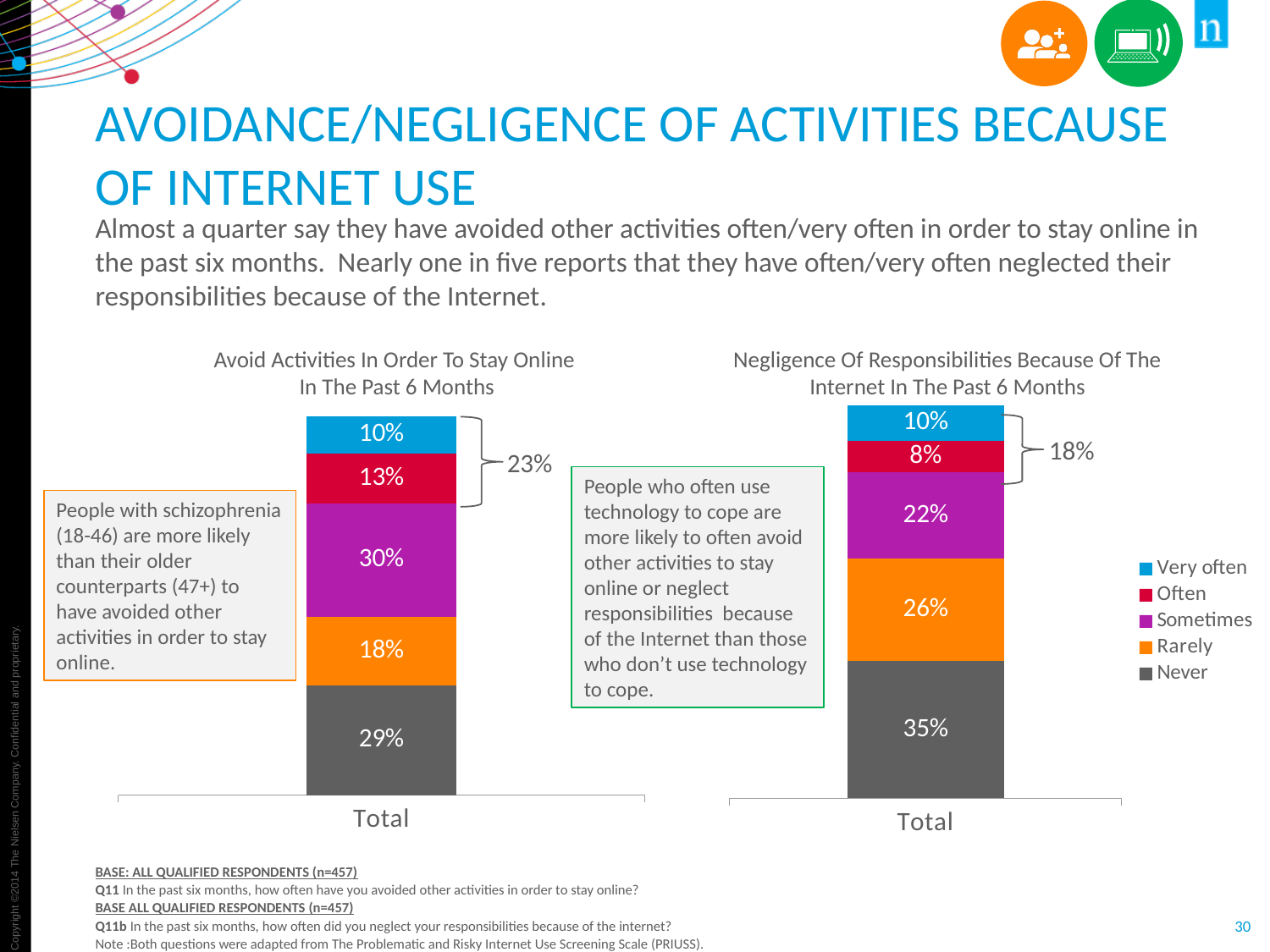
In the 'Avoid Activities In Order To Stay Online In The Past 6 Months' chart, what percentage is 'Sometimes'? 30% In the 'Negligence Of Responsibilities Because Of The Internet In The Past 6 Months' chart, what percentage is 'Often'? 8% In the 'Negligence Of Responsibilities Because Of The Internet In The Past 6 Months' chart, what is the combined percentage of 'Very often' and 'Often' shown by the bracket? 18% In the 'Avoid Activities In Order To Stay Online In The Past 6 Months' chart, which response category has the largest share? Sometimes In the 'Avoid Activities In Order To Stay Online In The Past 6 Months' chart, what percentage of the Total bar is 'Never'? 29% In the 'Avoid Activities In Order To Stay Online In The Past 6 Months' chart, what is the difference between the 'Sometimes' and 'Rarely' percentages? 12% How many response categories does the legend list? 5 What type of chart is used on this slide? Stacked bar chart In the 'Negligence Of Responsibilities Because Of The Internet In The Past 6 Months' chart, what percentage is 'Never'? 35% Is the 'Never' share larger in the 'Avoid Activities' chart or in the 'Negligence Of Responsibilities' chart? Negligence Of Responsibilities Which colour represents 'Rarely' in the legend? Orange In the 'Negligence Of Responsibilities Because Of The Internet In The Past 6 Months' chart, which response category has the smallest share? Often